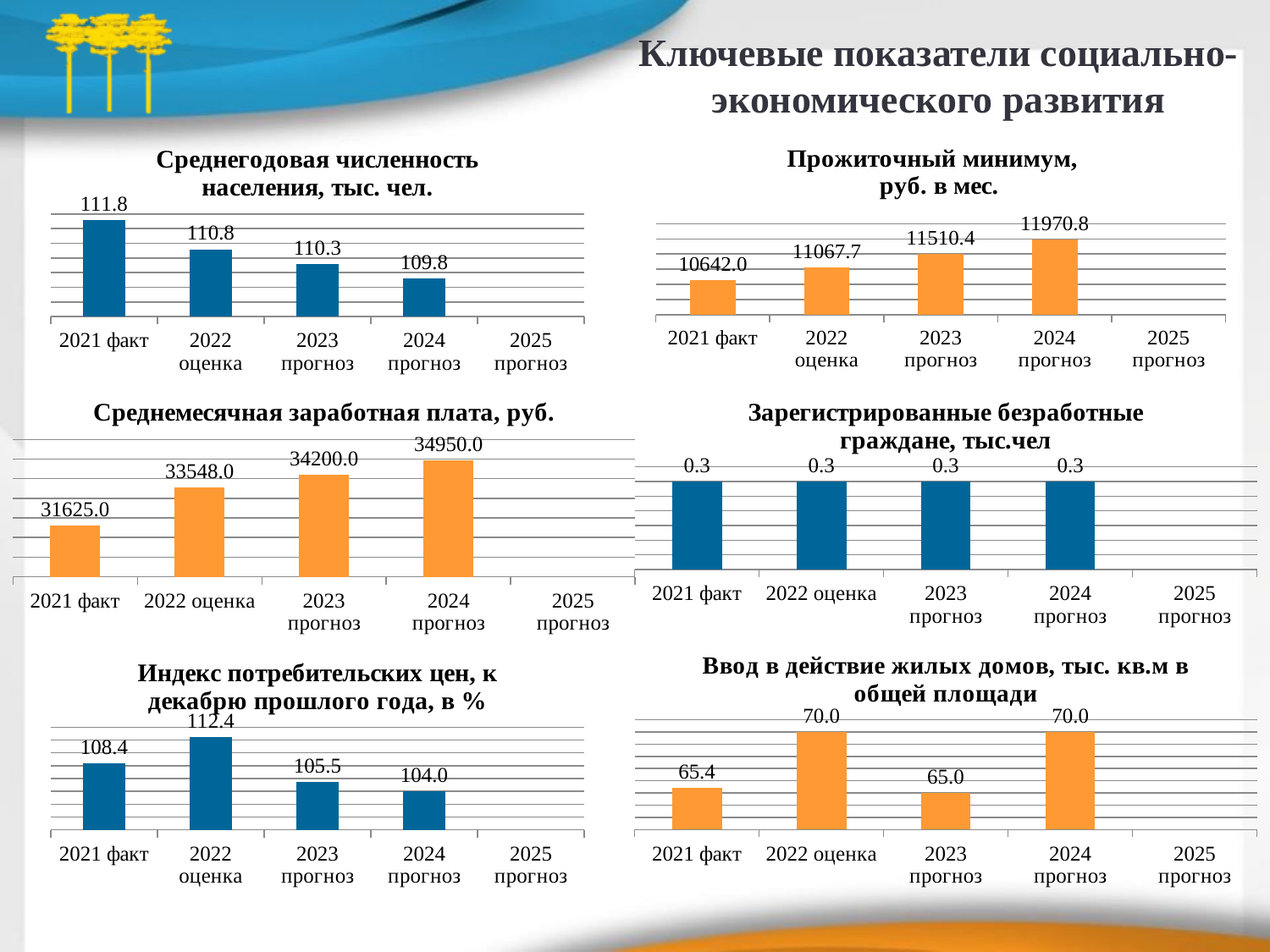
In the chart 'Среднегодовая численность населения, тыс. чел.', what is the value for 2021 факт? 111.8 What type of chart is 'Среднемесячная заработная плата, руб.'? bar chart In the chart 'Среднемесячная заработная плата, руб.', what is the difference between the 2024 прогноз and 2021 факт values? 3325.0 In the chart 'Прожиточный минимум, руб. в мес.', what is the value for 2024 прогноз? 11970.8 In the chart 'Индекс потребительских цен, к декабрю прошлого года, в %', which category has the highest value? 2022 оценка In the chart 'Зарегистрированные безработные граждане, тыс.чел', what is the value for 2023 прогноз? 0.3 In the chart 'Среднегодовая численность населения, тыс. чел.', do the values rise or fall from 2021 факт to 2024 прогноз? fall In the chart 'Ввод в действие жилых домов, тыс. кв.м в общей площади', which is larger: the value for 2021 факт or 2023 прогноз? 2021 факт In the chart 'Среднемесячная заработная плата, руб.', which category has the highest value? 2024 прогноз In the chart 'Прожиточный минимум, руб. в мес.', which category has the lowest value? 2021 факт In the chart 'Индекс потребительских цен, к декабрю прошлого года, в %', what is the difference between the 2022 оценка and 2024 прогноз values? 8.4 In the chart 'Ввод в действие жилых домов, тыс. кв.м в общей площади', what is the value for 2022 оценка? 70.0